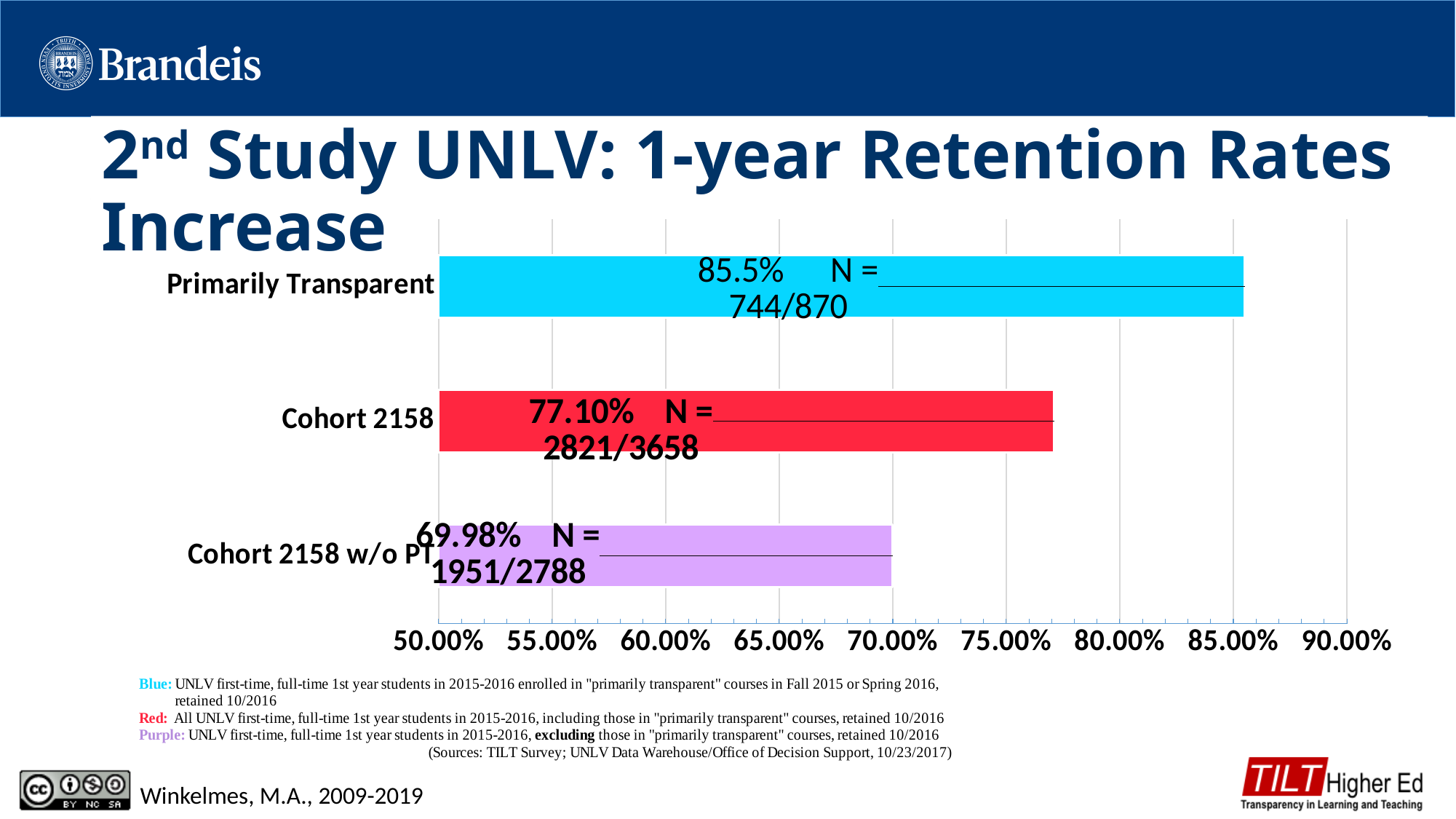
What is the 1-year retention rate for Primarily Transparent? 85.5% What is the 1-year retention rate for Cohort 2158? 77.10% What colour is the bar for Cohort 2158 w/o PT? Purple Which category has the highest retention rate? Primarily Transparent What is the 1-year retention rate for Cohort 2158 w/o PT? 69.98% How many categories are shown in the chart? 3 What is the difference in retention rate between Cohort 2158 and Cohort 2158 w/o PT? 7.12 percentage points Which category has the lowest retention rate? Cohort 2158 w/o PT What is the N value shown for the Primarily Transparent bar? 744/870 Which has a higher retention rate, Cohort 2158 or Cohort 2158 w/o PT? Cohort 2158 What kind of chart is shown on the slide? Bar chart What is the difference in retention rate between Primarily Transparent and Cohort 2158? 8.4 percentage points